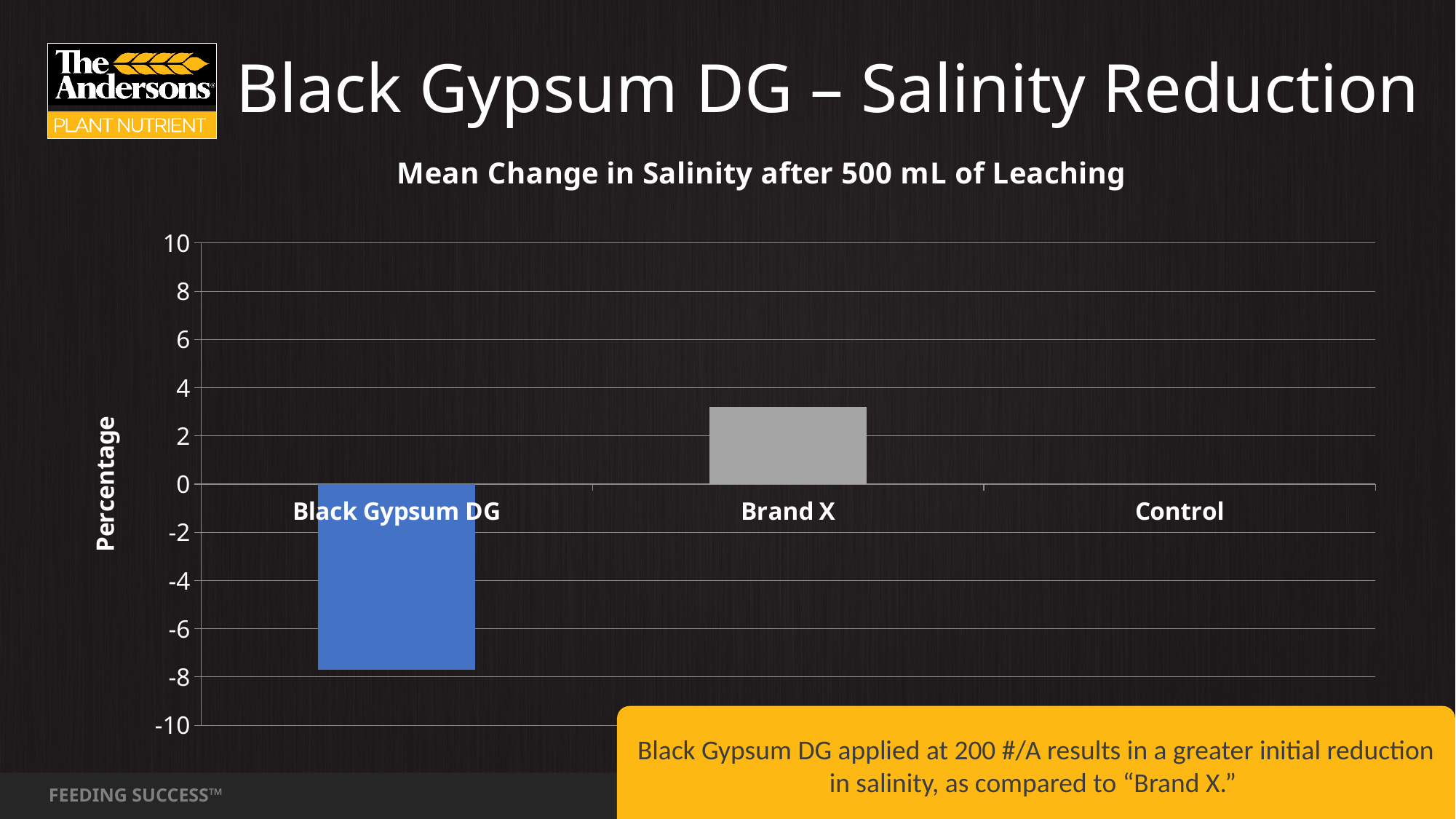
What is the title of the chart? Mean Change in Salinity after 500 mL of Leaching Which category has the highest value in the chart? Brand X Which is larger, the value for Brand X or the value for Black Gypsum DG? Brand X Which category has the lowest value in the chart? Black Gypsum DG Is the value for Brand X greater or less than 4? less Is the value for Black Gypsum DG greater or less than 0? less Is the value for Black Gypsum DG greater or less than -6? less How many categories are shown on the x axis of the chart? 3 Which category is the only one with a negative value in the chart? Black Gypsum DG What kind of chart is shown on the slide? Bar chart What is the label on the vertical axis of the chart? Percentage